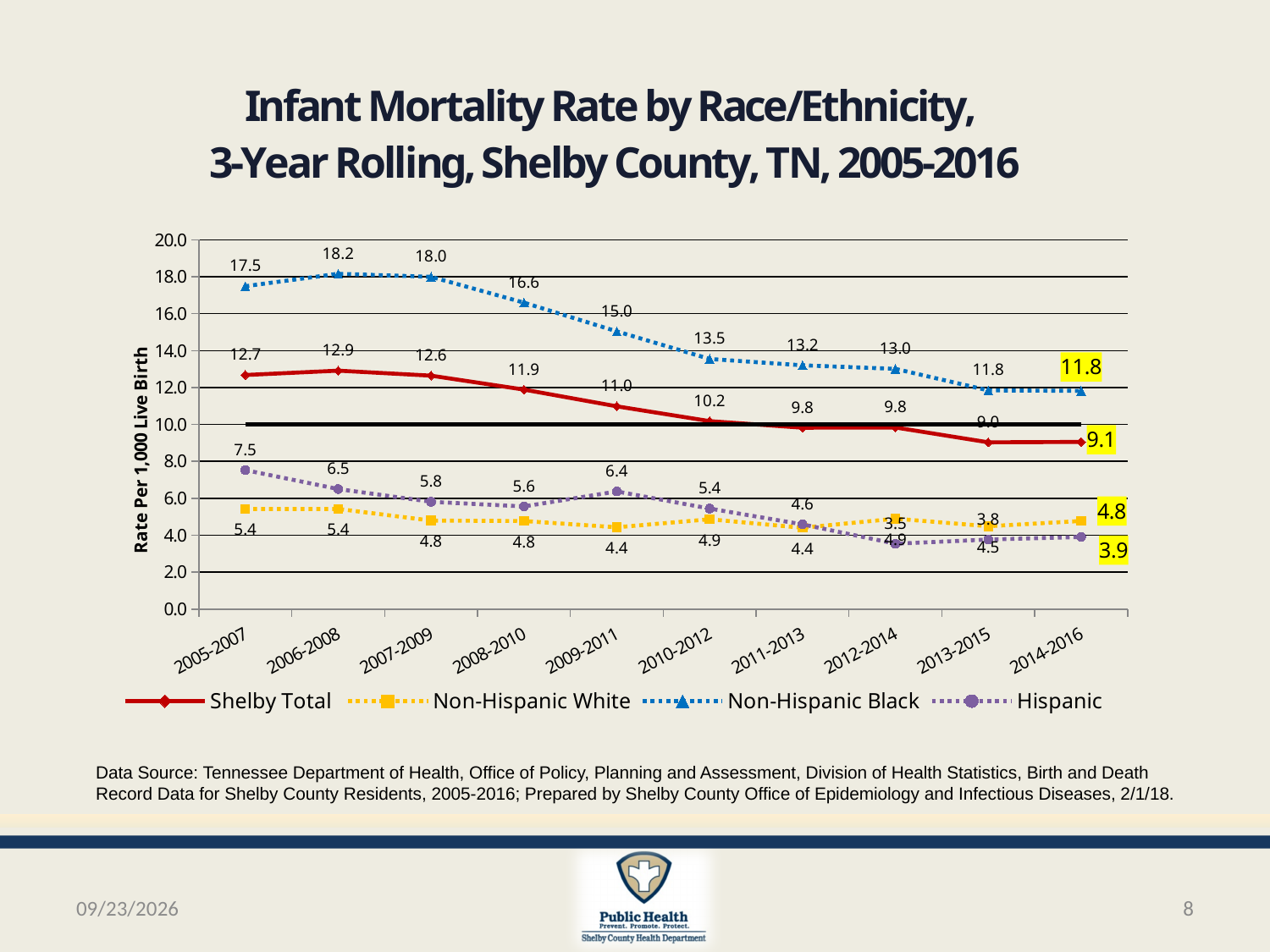
In 2014-2016, which is larger: the Non-Hispanic White rate or the Hispanic rate? Non-Hispanic White What is the Shelby Total infant mortality rate for 2014-2016? 9.1 In which period is the Hispanic rate lowest? 2012-2014 What is the Hispanic infant mortality rate for 2005-2007? 7.5 What is the Non-Hispanic Black infant mortality rate for 2006-2008? 18.2 What kind of chart is shown on the slide? Line chart What is the label on the y axis? Rate Per 1,000 Live Birth In which period is the Non-Hispanic Black rate highest? 2006-2008 What is the difference between the Non-Hispanic Black rate and the Shelby Total rate in 2005-2007? 4.8 Does the Shelby Total rate generally rise or fall from 2005-2007 to 2014-2016? Fall How many 3-year periods are plotted along the x axis? 10 How many series does the legend list? 4